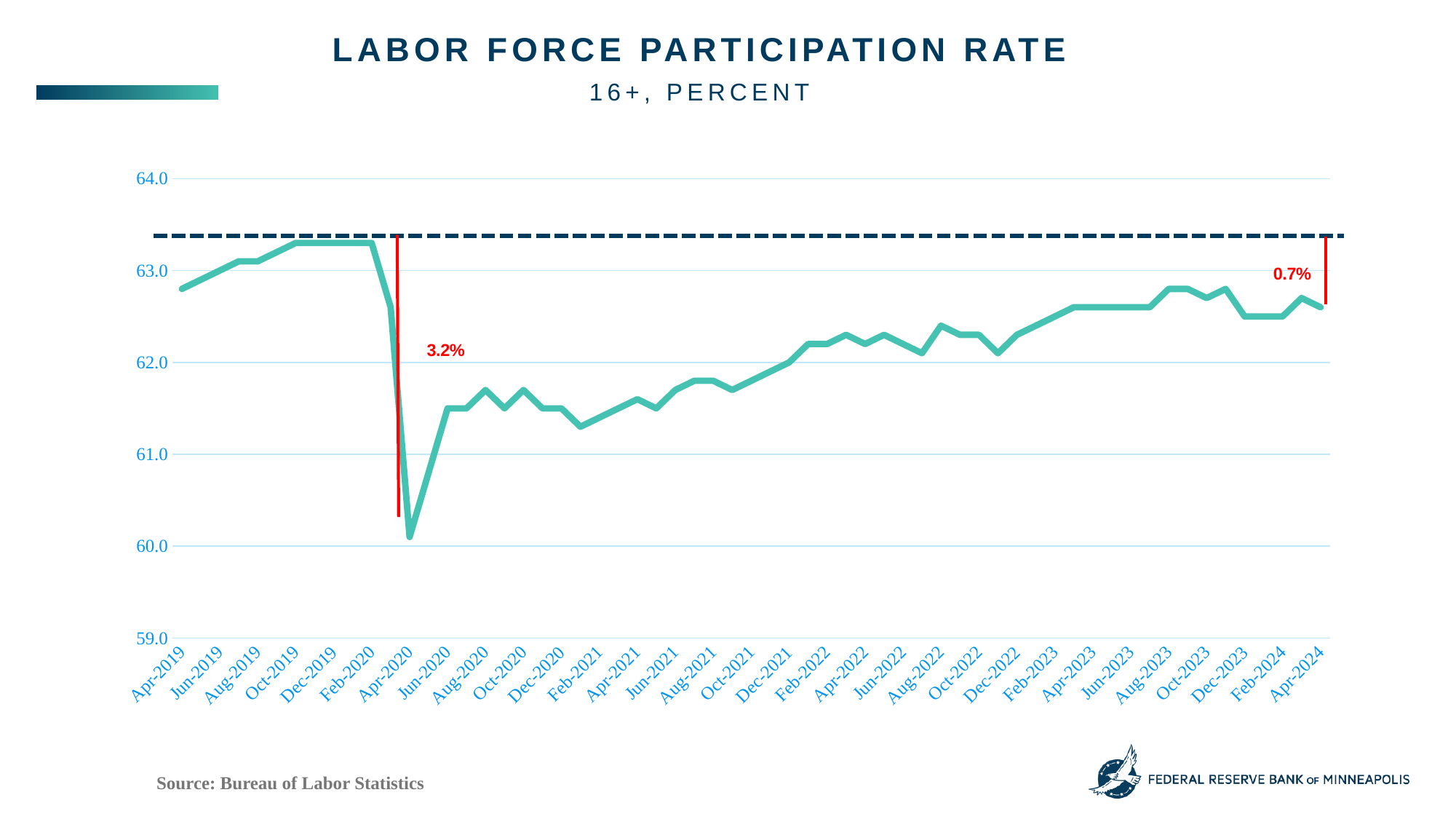
What kind of chart is shown on the slide? line chart Is the value for Apr-2024 greater or less than 62.0? greater What percentage label is printed in red next to the vertical red line at Apr-2024? 0.7% What is the title of the chart? LABOR FORCE PARTICIPATION RATE Is the value for Apr-2020 greater or less than 61.0? less Which is larger, the value for Feb-2020 or the value for Feb-2021? Feb-2020 Which month has the lowest labor force participation rate on the chart? Apr-2020 What subtitle appears under the chart title? 16+, PERCENT Is the value for Feb-2021 greater or less than 62.0? less Does the labor force participation rate generally rise or fall from Apr-2020 to Apr-2024? rise What percentage label is printed in red next to the vertical red line at Apr-2020? 3.2%